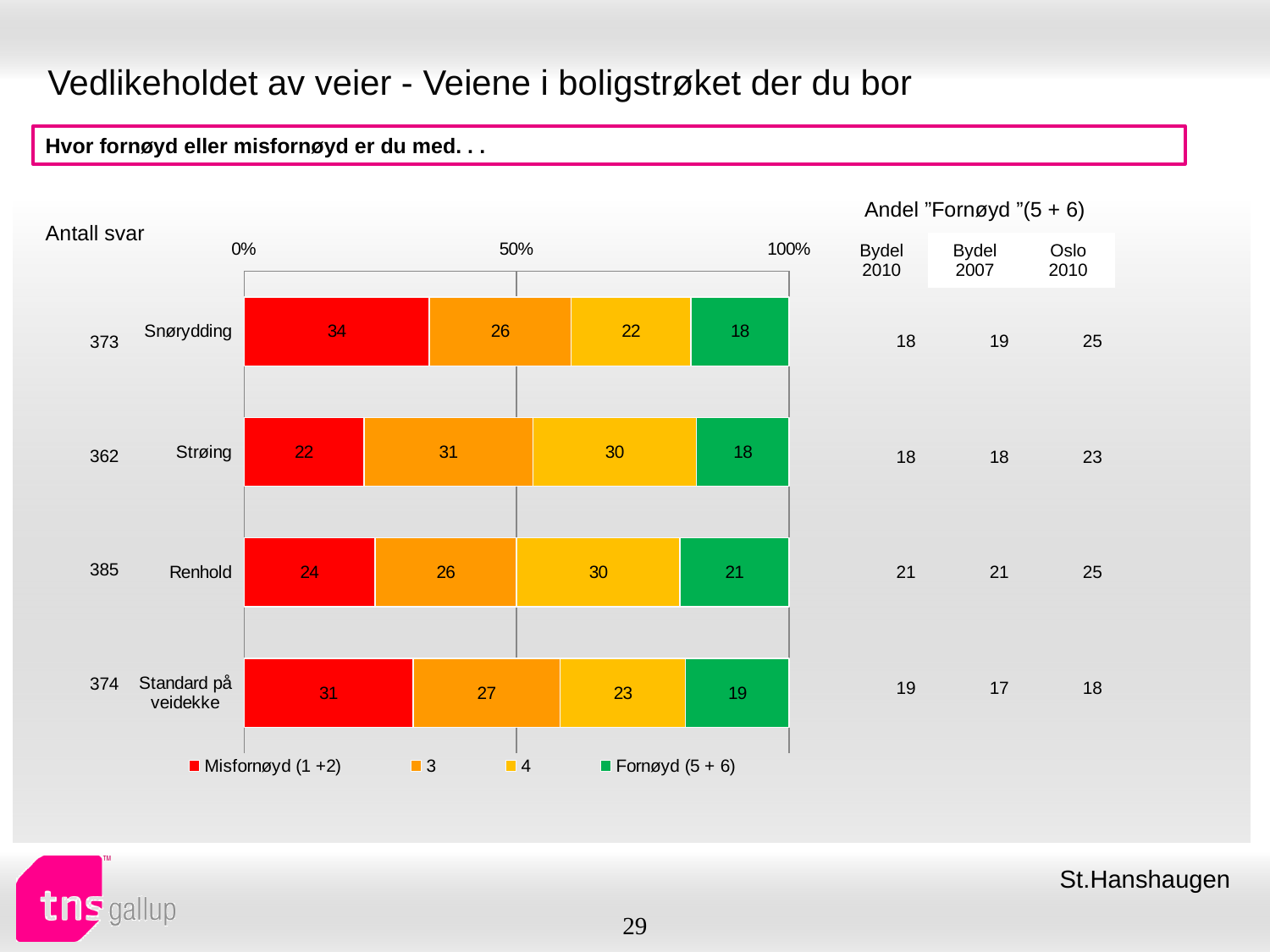
Which category has the lowest Misfornøyd (1 +2) value? Strøing What kind of chart is shown on the slide? stacked bar chart What is the Misfornøyd (1 +2) value for Snørydding? 34 What colour represents the Fornøyd (5 + 6) series in the chart? green What is the Fornøyd (5 + 6) value for Renhold? 21 Which is larger, the Fornøyd (5 + 6) value for Renhold or for Strøing? Renhold How many series does the legend list? 4 What is the value of series 4 for Standard på veidekke? 23 What is the difference between the Misfornøyd (1 +2) values for Snørydding and Standard på veidekke? 3 What is the value of series 3 for Strøing? 31 Which category has the highest Misfornøyd (1 +2) value? Snørydding How many categories are plotted in the chart? 4